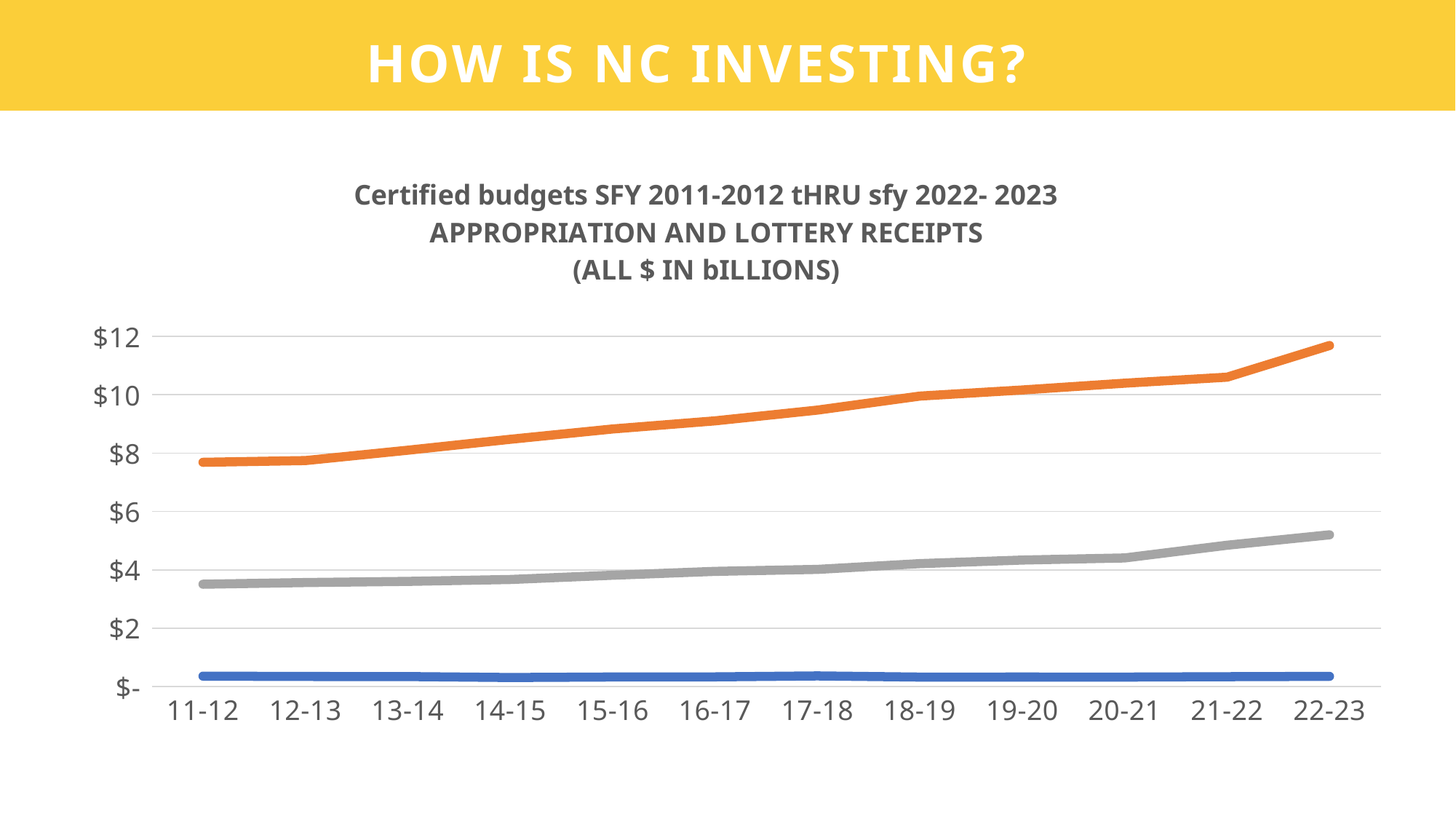
Does the gray line rise or fall from 11-12 to 22-23? rise What kind of chart is shown on the slide? line chart Is the value of the gray line at 22-23 greater or less than $4? greater Which line is higher at 16-17, the orange line or the gray line? orange line Is the value of the orange line at 11-12 greater or less than $8? less Does the orange line rise or fall from 11-12 to 22-23? rise Is the value of the blue line at 22-23 greater or less than $2? less Which coloured line has the lowest values across all years? blue line What unit does the chart title say all dollar values are in? billions How many lines are plotted on the chart? 3 How many fiscal years are shown along the x axis of the chart? 12